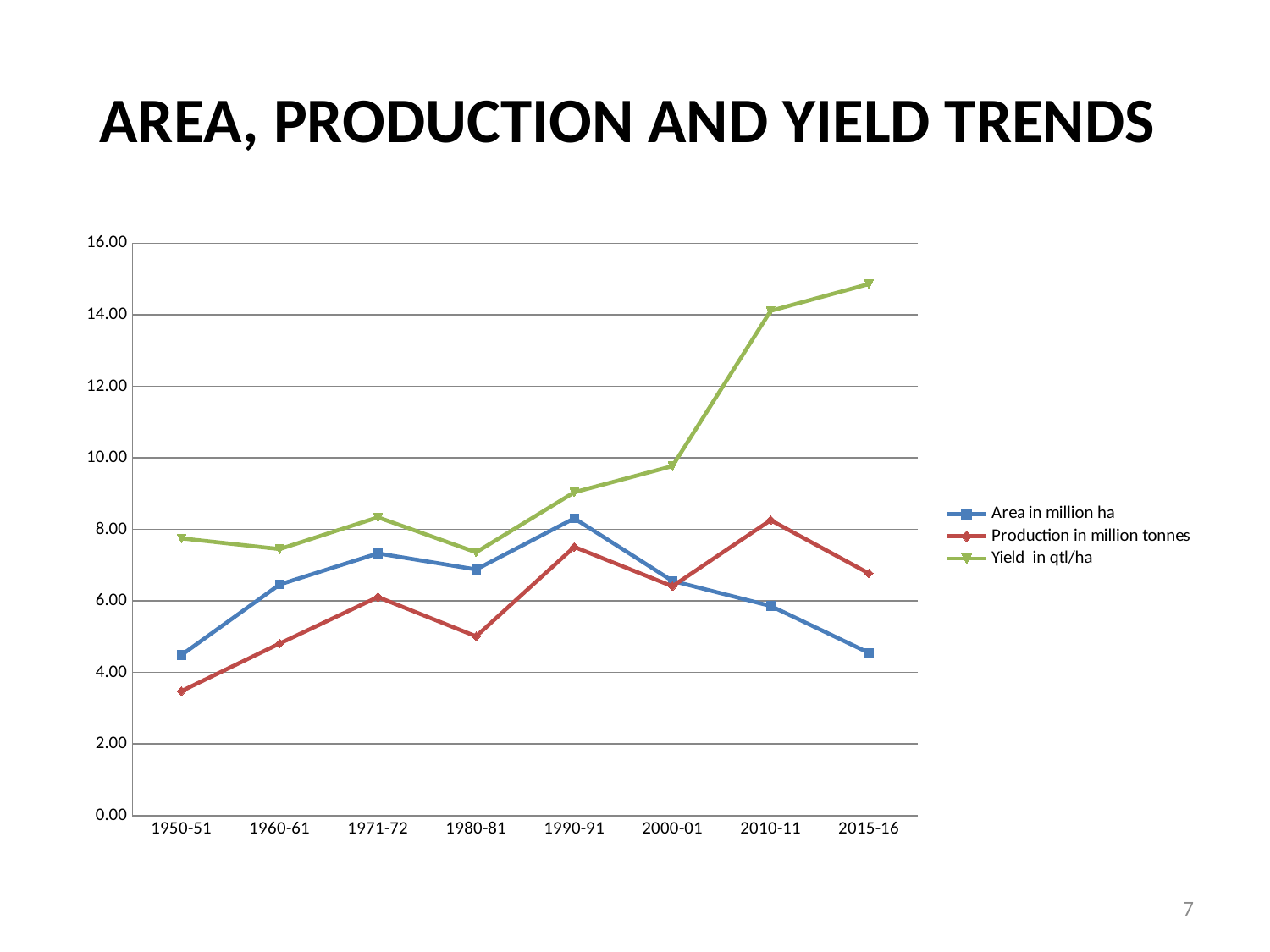
In which period is Production in million tonnes lowest? 1950-51 In which period is Area in million ha highest? 1990-91 What kind of chart is shown on the slide? Line chart Which series is drawn with the green line? Yield in qtl/ha Is the value for Yield in qtl/ha in 2010-11 greater or less than 12.00? greater In which period is Yield in qtl/ha highest? 2015-16 Is the value for Production in million tonnes in 1950-51 greater or less than 4.00? less In 2010-11, which is larger: Production in million tonnes or Area in million ha? Production in million tonnes How many series does the legend list? 3 Does Yield in qtl/ha rise or fall from 2000-01 to 2015-16? Rise How many time periods are plotted along the x axis? 8 Is the value for Area in million ha in 2015-16 greater or less than 6.00? less